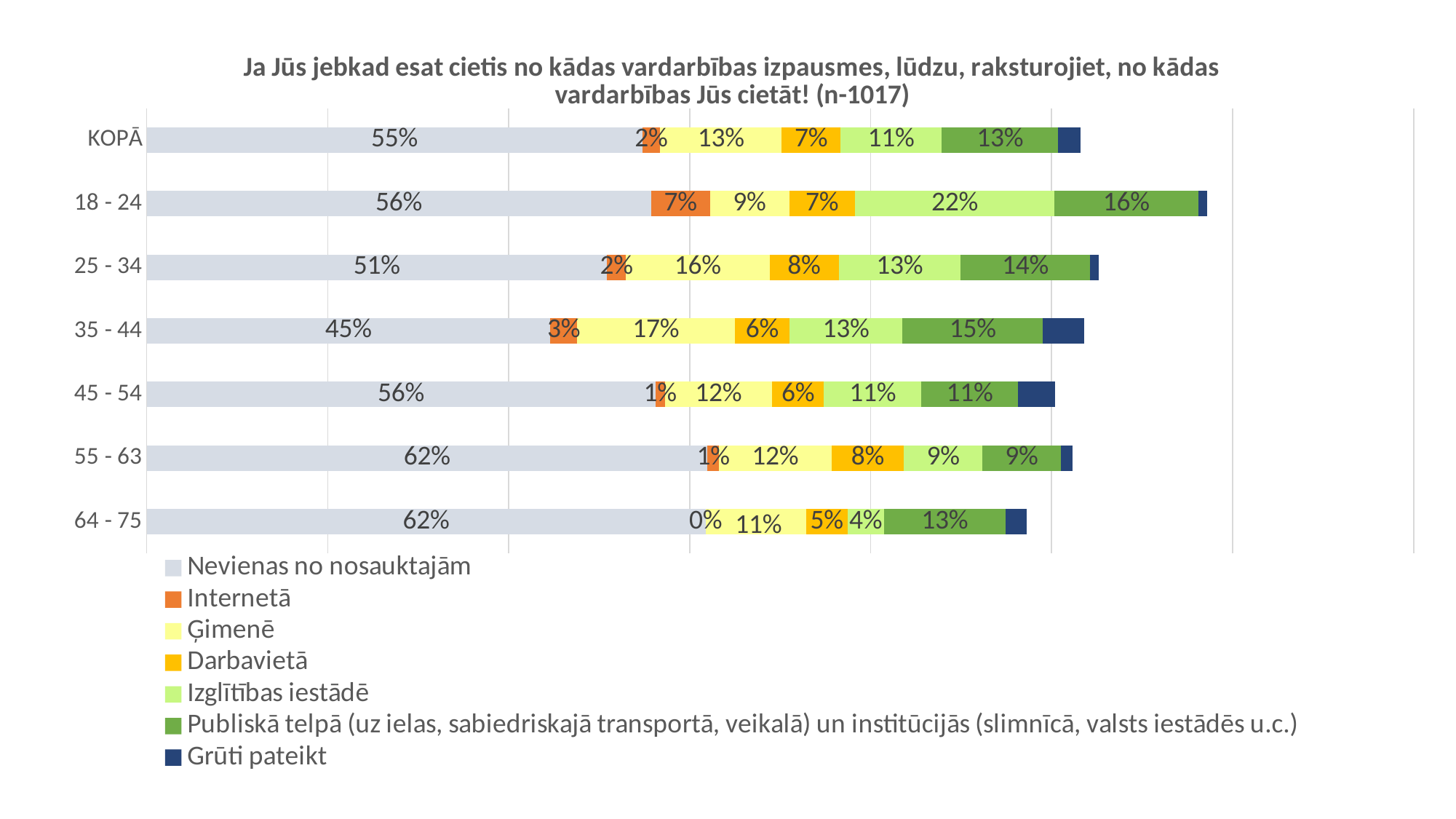
What is the value of "Publiskā telpā (uz ielas, sabiedriskajā transportā, veikalā) un institūcijās" for KOPĀ? 13% What is the value of "Izglītības iestādē" for the 18 - 24 group? 22% What is the difference between the "Nevienas no nosauktajām" values for the 55 - 63 group and the 35 - 44 group? 17 percentage points How many age-group categories (including KOPĀ) are plotted on the chart? 7 How many series does the legend list? 7 What is the first entry listed in the legend? Nevienas no nosauktajām Which group has the highest value for "Izglītības iestādē"? 18 - 24 What is the value of "Darbavietā" for the 25 - 34 group? 8% Which group has the lowest value for "Nevienas no nosauktajām"? 35 - 44 Which group has the larger "Publiskā telpā" value, 18 - 24 or 45 - 54? 18 - 24 What kind of chart is shown on the slide? Stacked bar chart What is the value of "Nevienas no nosauktajām" for the 35 - 44 group? 45%